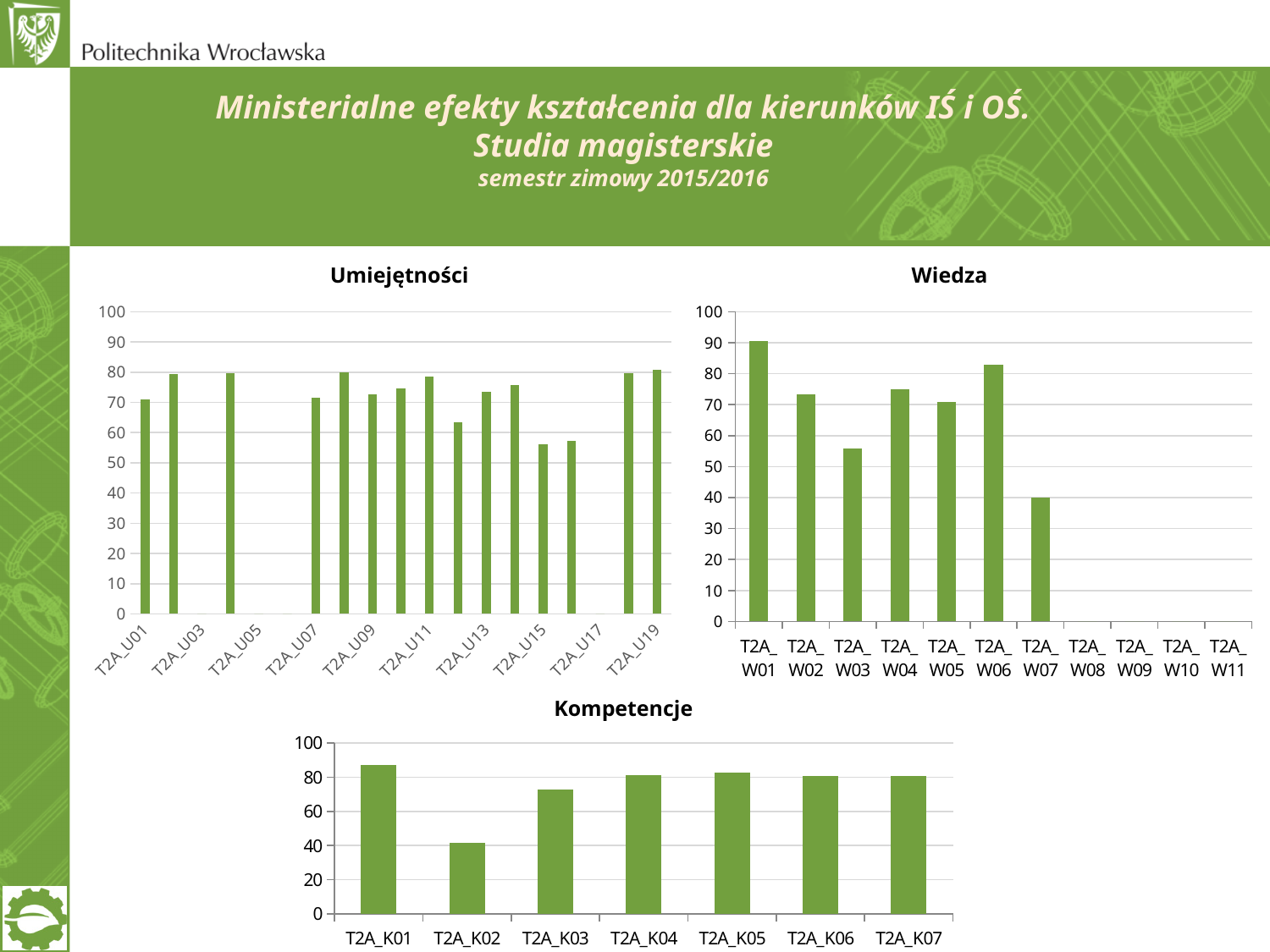
How many categories are shown in the Kompetencje chart? 7 In the Kompetencje chart, is the value for T2A_K02 greater or less than 60? less In the Wiedza chart, is the value for T2A_W07 greater or less than 50? less In the Kompetencje chart, which category has the highest value? T2A_K01 How many categories are shown on the x axis of the Wiedza chart? 11 In the Wiedza chart, which category has the highest value? T2A_W01 In the Wiedza chart, which is larger, the value for T2A_W03 or the value for T2A_W06? T2A_W06 In the Wiedza chart, is the value for T2A_W01 greater or less than 80? greater What type of chart is the Wiedza chart? bar chart What is the title of the chart in the top left of the slide? Umiejętności In the Kompetencje chart, which category has the lowest value? T2A_K02